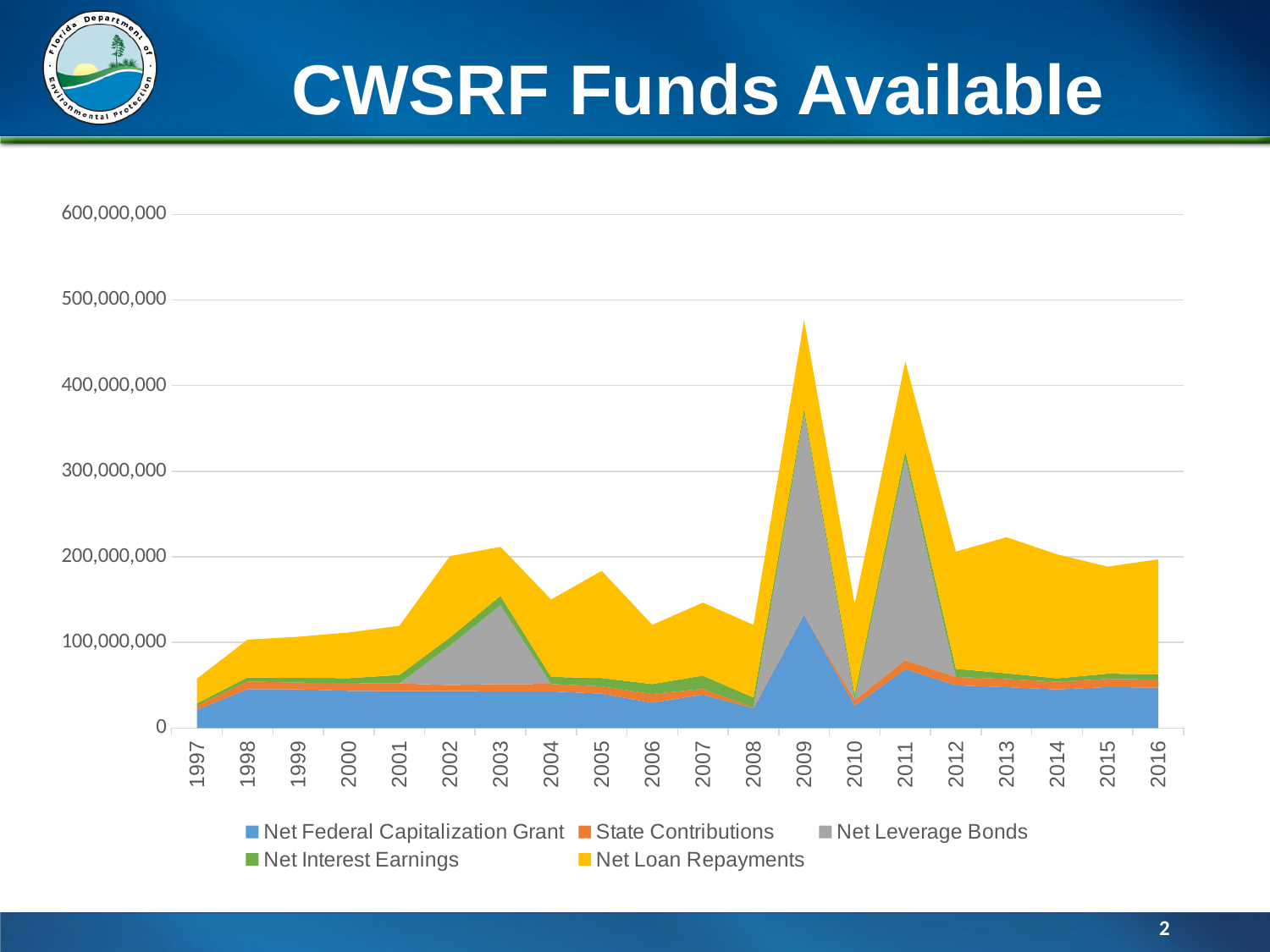
How many series does the legend list? 5 Is the total funds available in 2009 greater or less than 400,000,000? greater Is the total funds available in 1997 greater or less than 100,000,000? less Which year has a larger total of funds available, 2009 or 2011? 2009 Does the total of funds available rise or fall from 1997 to 2002? rise Which colour represents Net Loan Repayments in the chart? Yellow Is the total funds available in 2013 greater or less than 200,000,000? greater What is the title of the chart? CWSRF Funds Available How many years are shown along the x axis? 20 In which year is the total of funds available highest? 2009 What kind of chart is shown on the slide? Stacked area chart